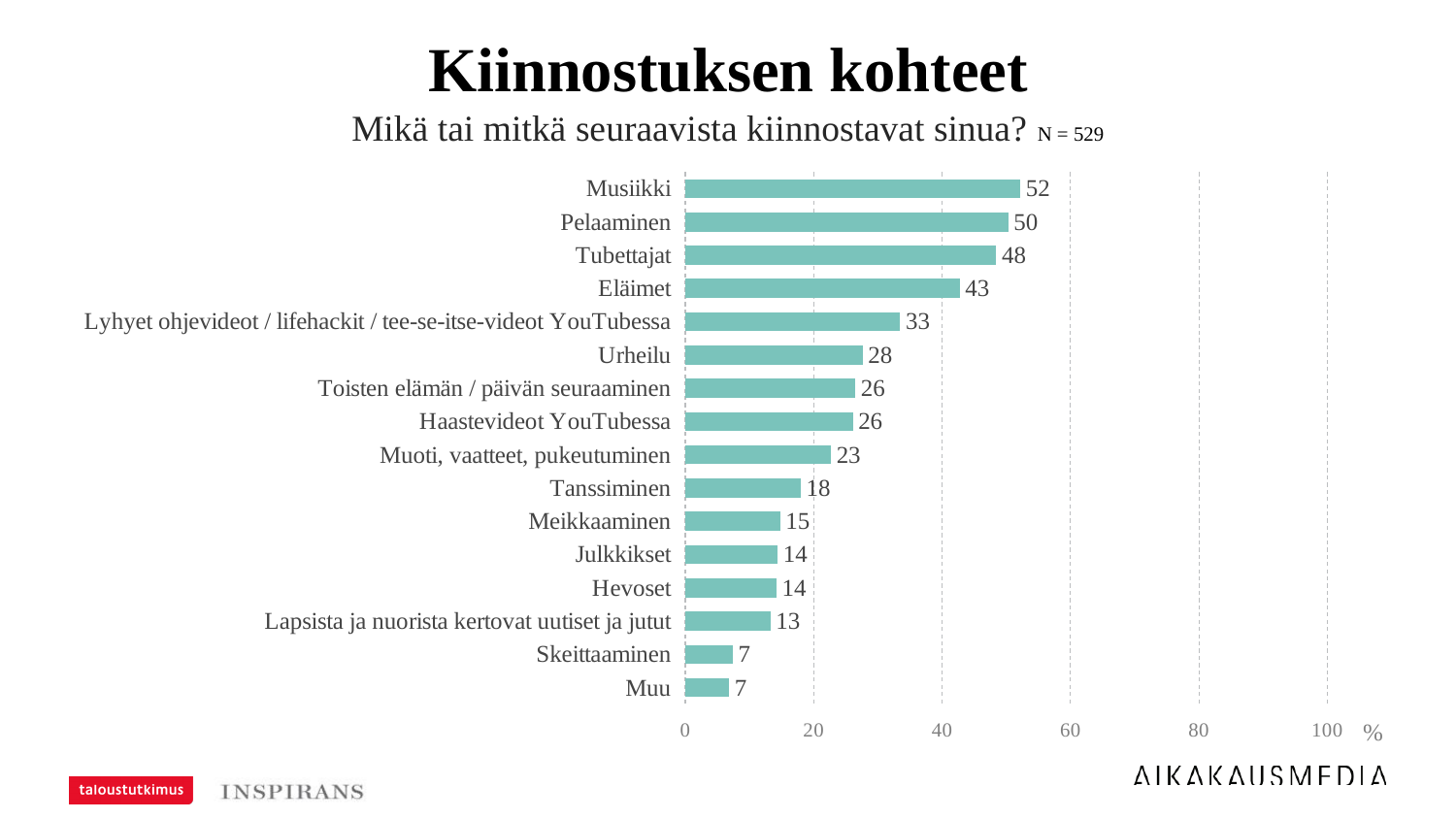
What is the sample size (N) stated on the slide? 529 What kind of chart is shown on the slide? bar chart Is the value for Lyhyet ohjevideot / lifehackit / tee-se-itse-videot YouTubessa greater or less than 40? less What is the value for Tanssiminen? 18 What is the value for Eläimet? 43 Which categories share the lowest value? Skeittaaminen and Muu What is the difference between the values for Pelaaminen and Tubettajat? 2 Which category has the highest value? Musiikki Which is larger, the value for Eläimet or the value for Urheilu? Eläimet What is the difference between the values for Musiikki and Urheilu? 24 How many categories are shown in the chart? 16 What is the value for Musiikki? 52